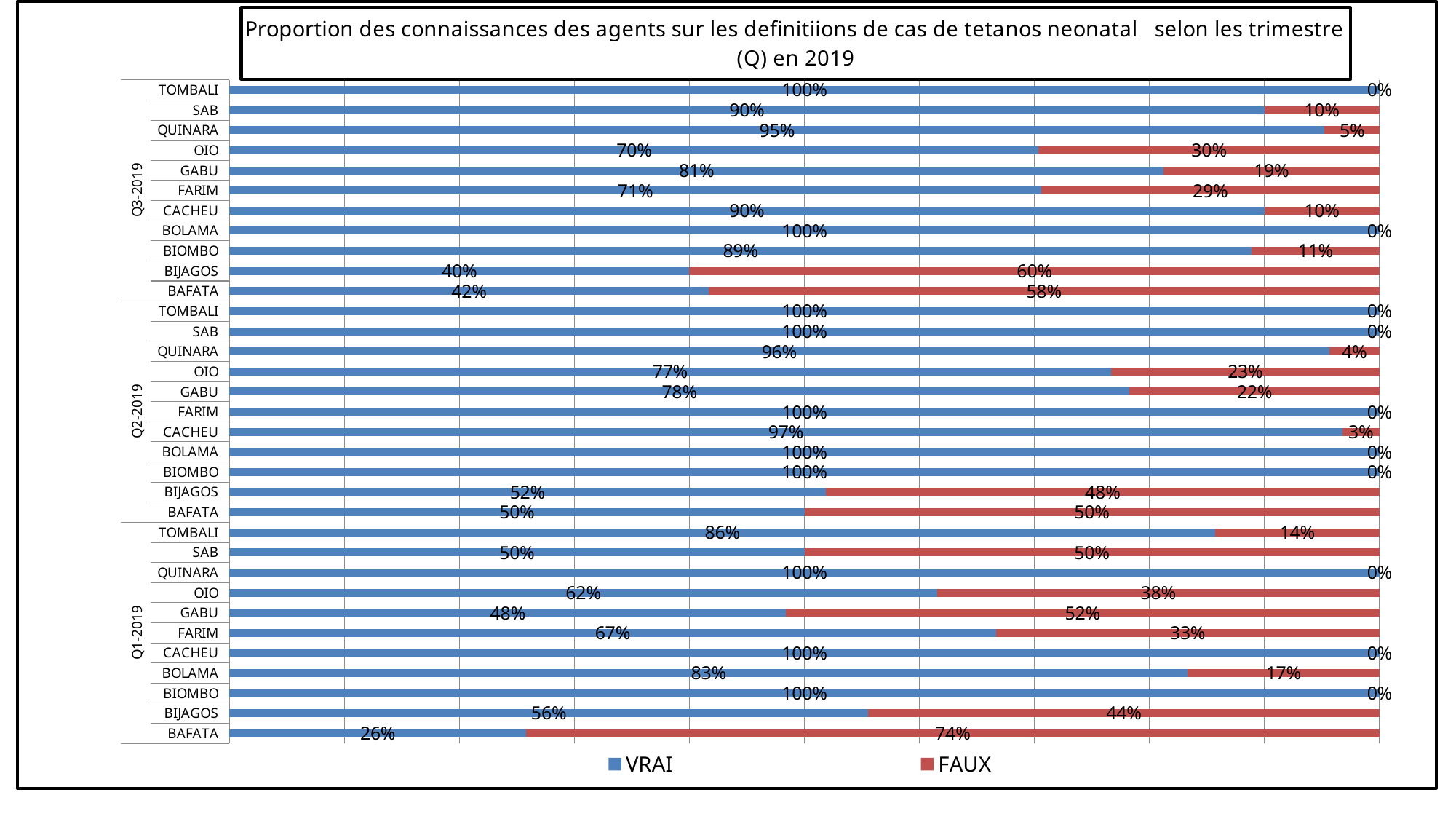
What are the two legend entries of the chart? VRAI and FAUX How much higher is the VRAI value for OIO in Q3-2019 than in Q1-2019? 8 percentage points How many series does the legend list? 2 From Q1-2019 to Q3-2019, does the VRAI value for BIJAGOS rise or fall? Fall What is the FAUX value for CACHEU in Q2-2019? 3% How many regions are listed within each quarter group? 11 Within Q1-2019, which region has the lowest VRAI value? BAFATA Within Q3-2019, which region has the highest FAUX value? BIJAGOS Is the VRAI value for GABU larger in Q2-2019 or in Q3-2019? Q3-2019 What is the FAUX value for BIJAGOS in Q3-2019? 60% What kind of chart is shown on the slide? Stacked bar chart What is the VRAI value for BAFATA in Q1-2019? 26%